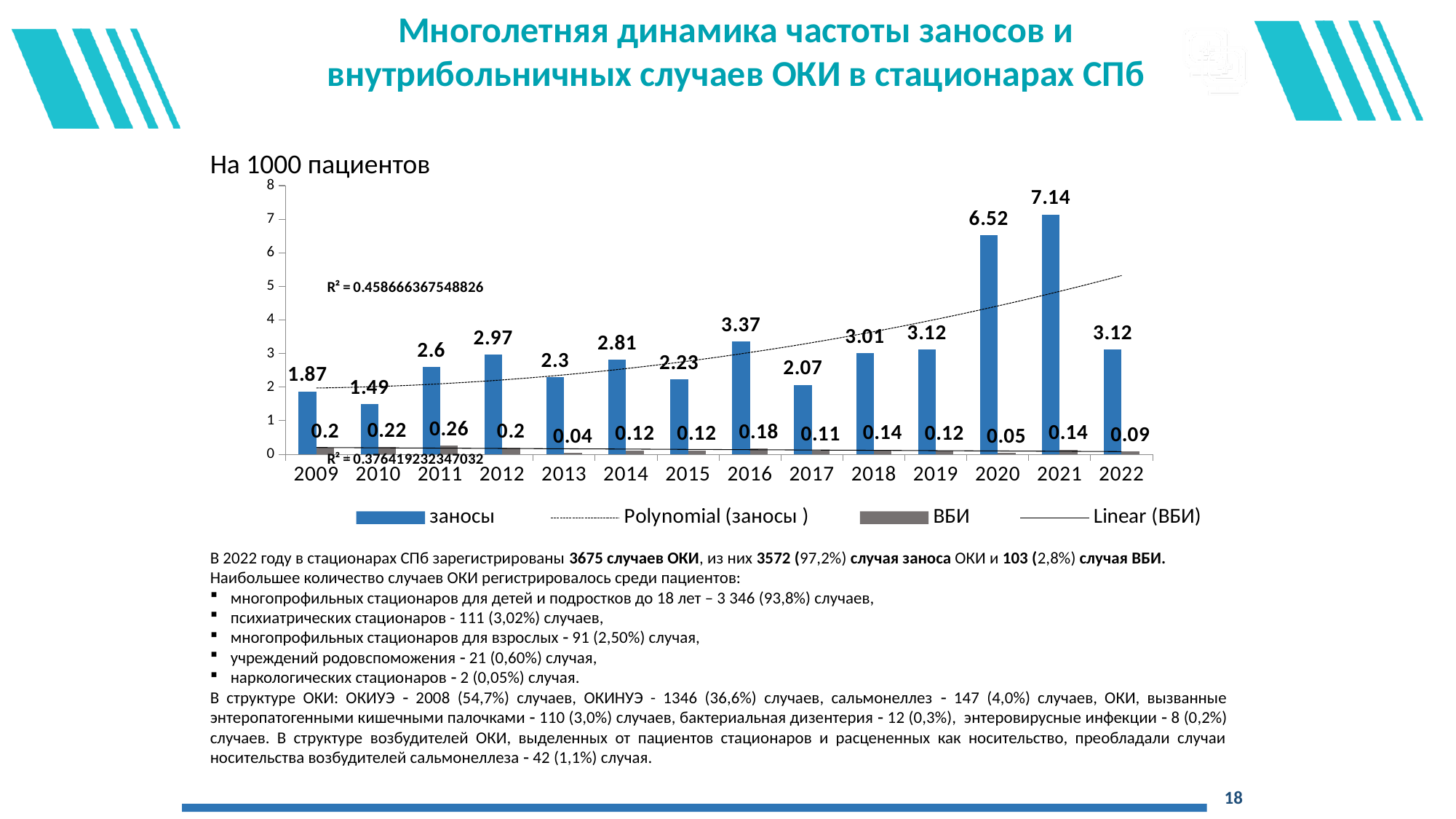
What kind of chart is shown on the slide? Bar chart In which year is the заносы value highest? 2021 What is the value for заносы in 2021? 7.14 How many entries does the legend list? 4 Which year has the larger заносы value, 2016 or 2018? 2016 In which year is the заносы value lowest? 2010 How many years are shown on the x axis? 14 What R² value is shown for the polynomial trendline of заносы? 0.458666367548826 What is the value for заносы in 2022? 3.12 In which year is the ВБИ value highest? 2011 What is the value for ВБИ in 2013? 0.04 What is the difference between the заносы values for 2021 and 2020? 0.62